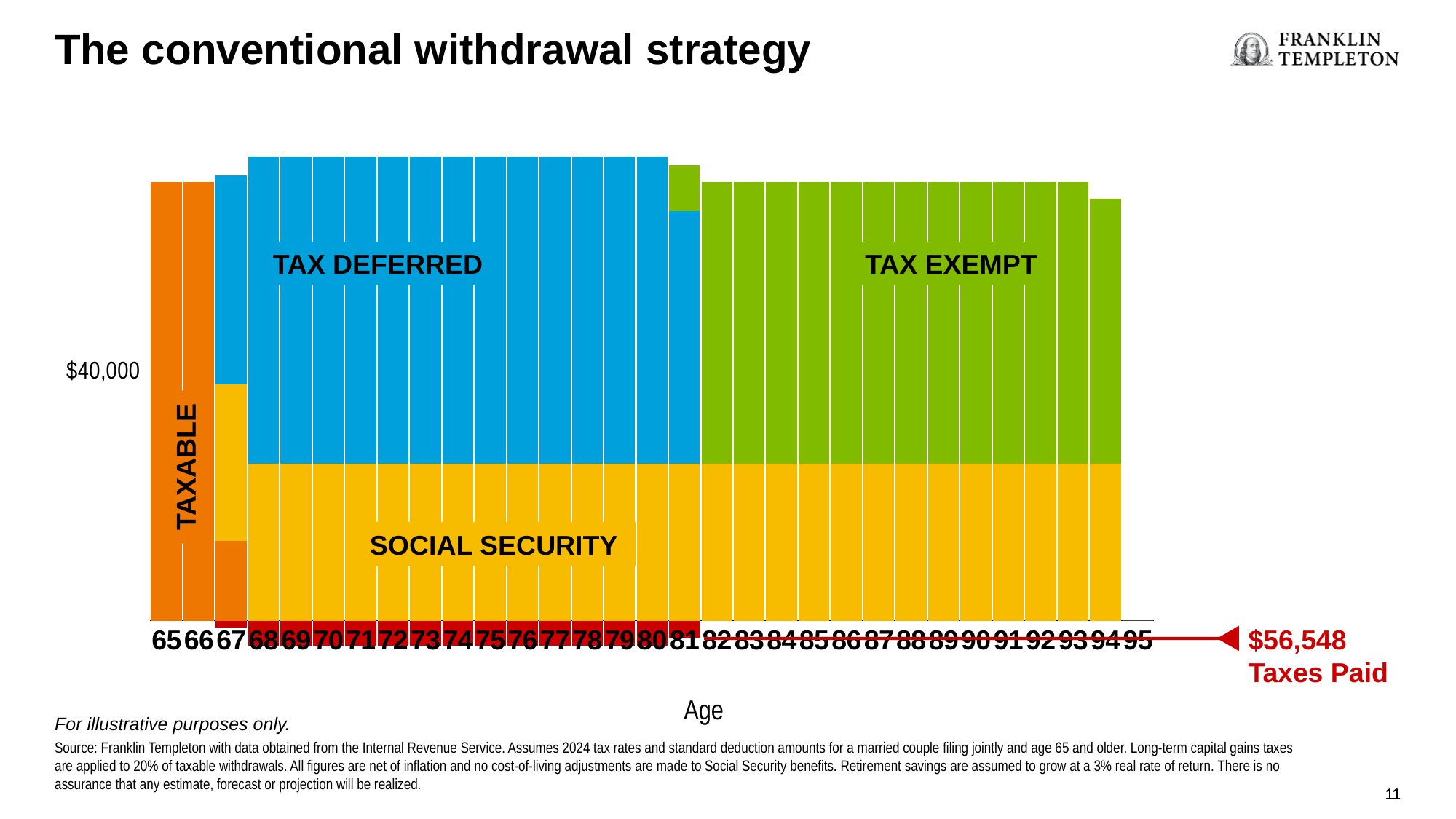
Is the Social Security portion for age 75 greater or less than $40,000? less What kind of chart is shown on the slide? Stacked bar chart Which age has the taller total bar, 75 or 95? 75 Is the total withdrawal for age 70 greater or less than $40,000? greater What is the total amount of taxes paid shown on the slide? $56,548 What is the title of the chart on the slide? The conventional withdrawal strategy Which income source is drawn for age 65? Taxable How many ages are shown along the x axis? 31 Which two income sources make up the bar for age 90? Tax exempt and Social Security Which age has the taller total bar, 65 or 70? 70 Which age has the taller total bar, 93 or 94? 93 What is the label of the x axis? Age